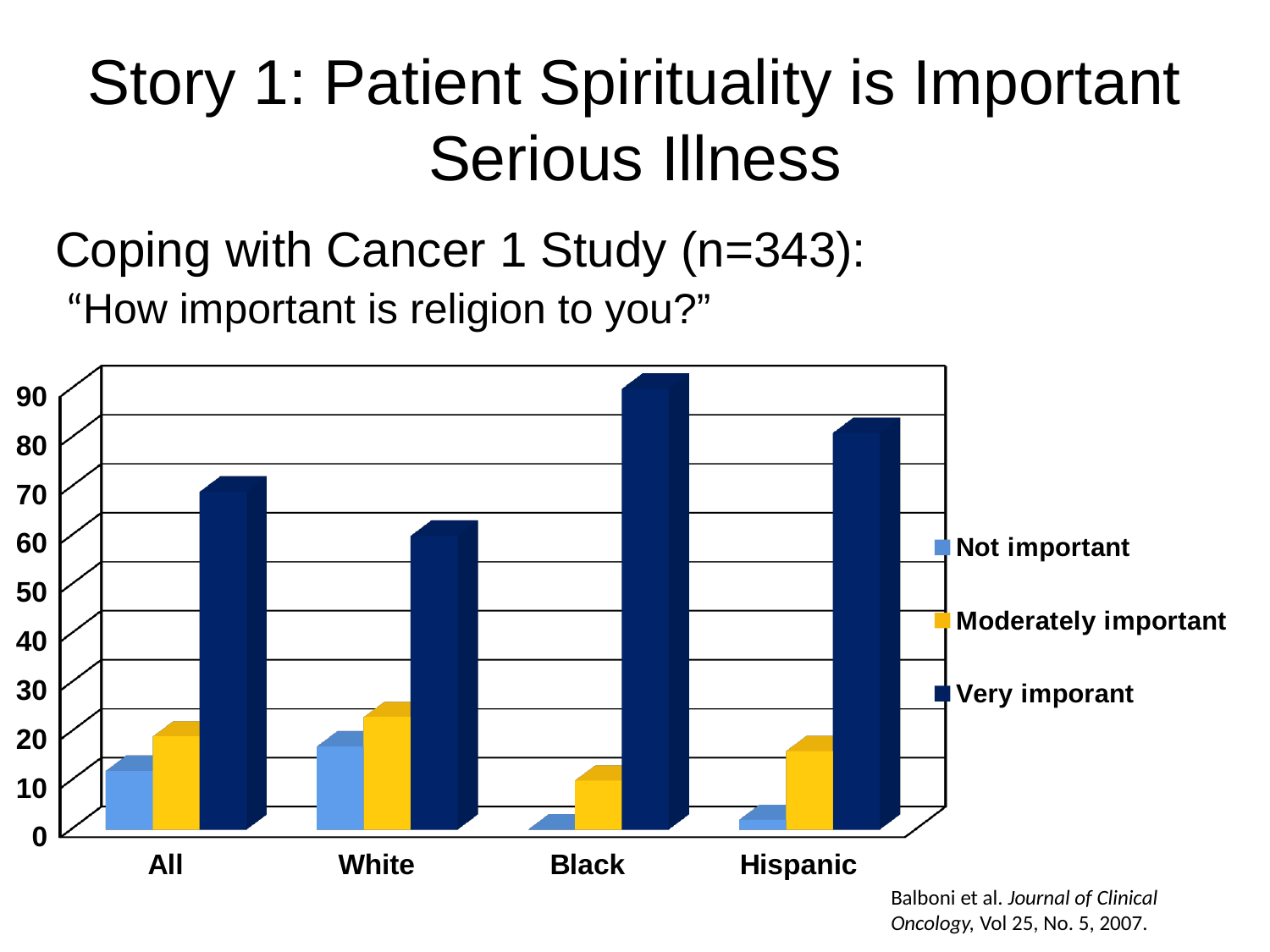
How many categories are shown along the x axis of the chart? 4 Which category has the highest value for the Not important series? White Which series is shown in yellow in the chart's legend? Moderately important How many series does the chart's legend list? 3 Is the Very important value for All greater or less than 60? greater What kind of chart is shown on the slide? bar chart Is the Moderately important value for Black greater or less than 20? less Is the Very important value for Black greater or less than 80? greater Which is larger: the Very important value for Black or for Hispanic? Black Which category has the lowest value for the Very important series? White Which category has the highest value for the Very important series? Black